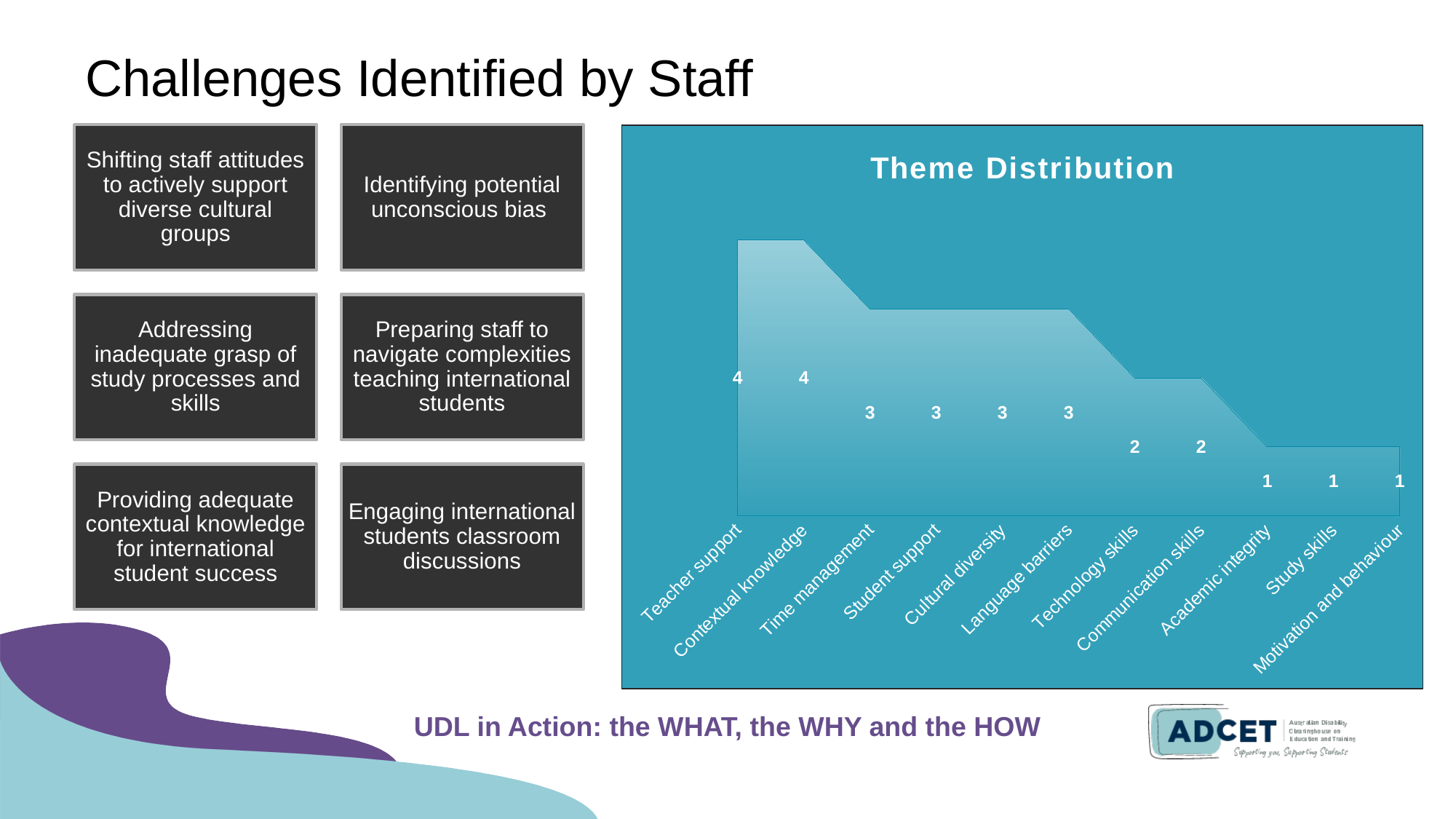
What kind of chart is the Theme Distribution chart? Area chart What is the highest value shown in the Theme Distribution chart? 4 Do the values in the Theme Distribution chart rise or fall from left to right along the x axis? Fall What is the value for Motivation and behaviour in the Theme Distribution chart? 1 What is the difference between the values for Contextual knowledge and Academic integrity in the Theme Distribution chart? 3 What is the value for Teacher support in the Theme Distribution chart? 4 What is the title of the chart on the slide? Theme Distribution How many categories are shown on the x axis of the Theme Distribution chart? 11 What is the value for Language barriers in the Theme Distribution chart? 3 Which has a larger value in the Theme Distribution chart, Student support or Communication skills? Student support What is the value for Technology skills in the Theme Distribution chart? 2 What is the value for Time management in the Theme Distribution chart? 3